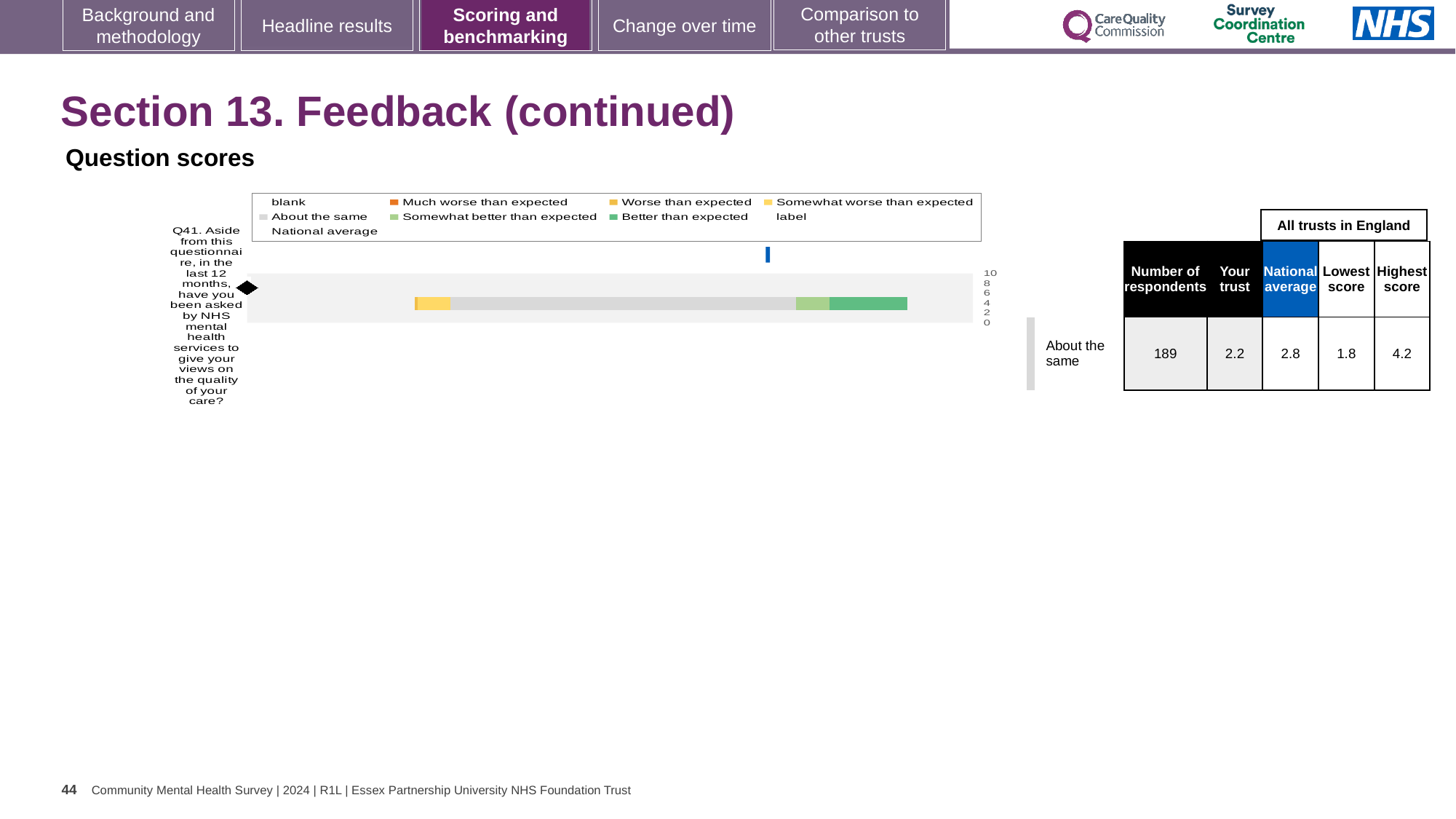
What is the highest score among all trusts in England for Q41? 4.2 What is the national average score for Q41? 2.8 How many questions (categories) are plotted in the chart? 1 What benchmark category is shown for Q41 next to the chart? About the same What is the lowest score among all trusts in England for Q41? 1.8 What is the difference between the national average and the 'Your trust' score for Q41? 0.6 Which is larger for Q41, the 'Your trust' score or the national average? National average What is the 'Your trust' score for Q41? 2.2 What kind of chart is shown on the slide? bar chart What is the difference between the highest score and the lowest score for Q41? 2.4 Which question is plotted in the chart? Q41. Aside from this questionnaire, in the last 12 months, have you been asked by NHS mental health services to give your views on the quality of your care? What is the number of respondents for Q41? 189